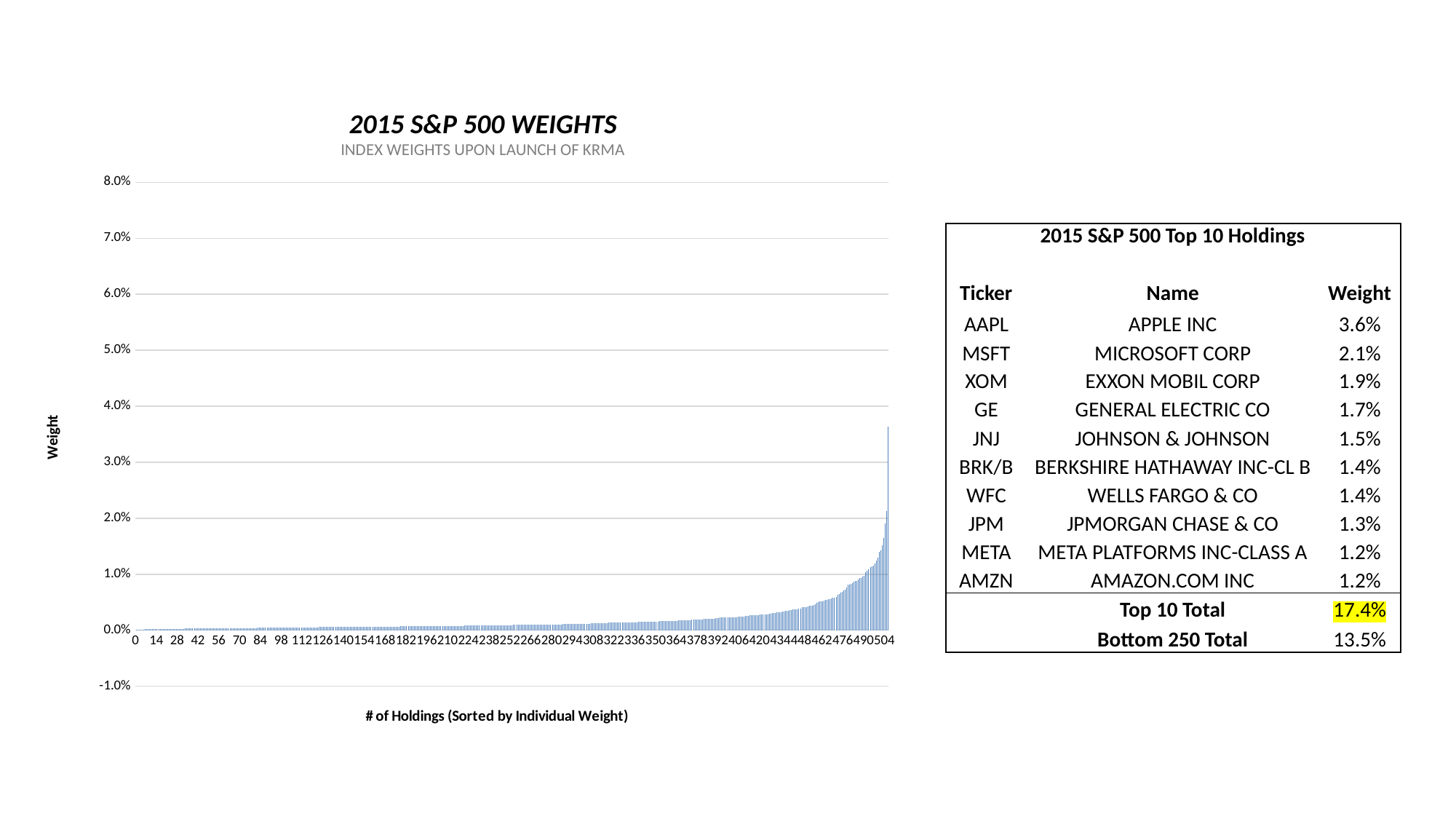
Is the value of the tallest bar in the chart greater or less than 3.0%? greater Is the value of the bar at holding 420 greater or less than 1.0%? less Do the bar heights rise or fall moving from left to right along the x axis? rise Is the value of the tallest bar in the chart greater or less than 4.0%? less What is the title of the chart? 2015 S&P 500 WEIGHTS What is the x-axis title of the chart? # of Holdings (Sorted by Individual Weight) What kind of chart is shown on the slide? bar chart Which end of the x axis, left or right, has the bar with the highest weight? right